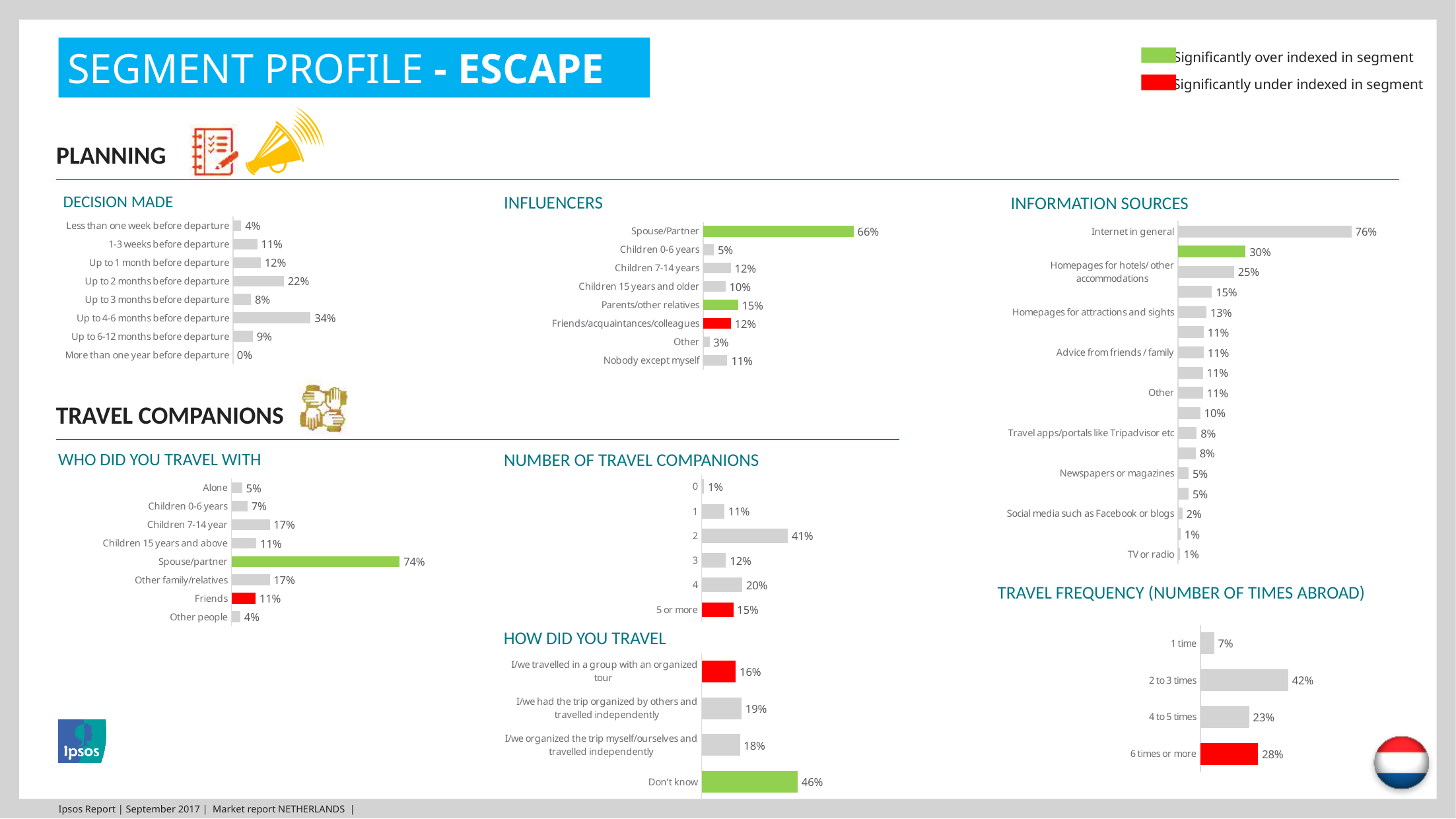
In the WHO DID YOU TRAVEL WITH chart, which category has the highest value? Spouse/partner In the WHO DID YOU TRAVEL WITH chart, how many categories are shown? 8 In the INFLUENCERS chart, what is the difference between Parents/other relatives and Children 0-6 years? 10% In the NUMBER OF TRAVEL COMPANIONS chart, which is larger: the value for 2 or the value for 4? 2 What type of chart is the TRAVEL FREQUENCY (NUMBER OF TIMES ABROAD) chart? Bar chart In the TRAVEL FREQUENCY (NUMBER OF TIMES ABROAD) chart, what is the difference between '2 to 3 times' and '6 times or more'? 14% In the INFORMATION SOURCES chart, what is the value for 'Internet in general'? 76% In the DECISION MADE chart, which category has the lowest value? More than one year before departure In the DECISION MADE chart, what is the value for 'Up to 4-6 months before departure'? 34% In the HOW DID YOU TRAVEL chart, what is the value for 'Don't know'? 46% In the INFLUENCERS chart, what is the value for Spouse/Partner? 66% In the INFORMATION SOURCES chart, what is the value for 'TV or radio'? 1%